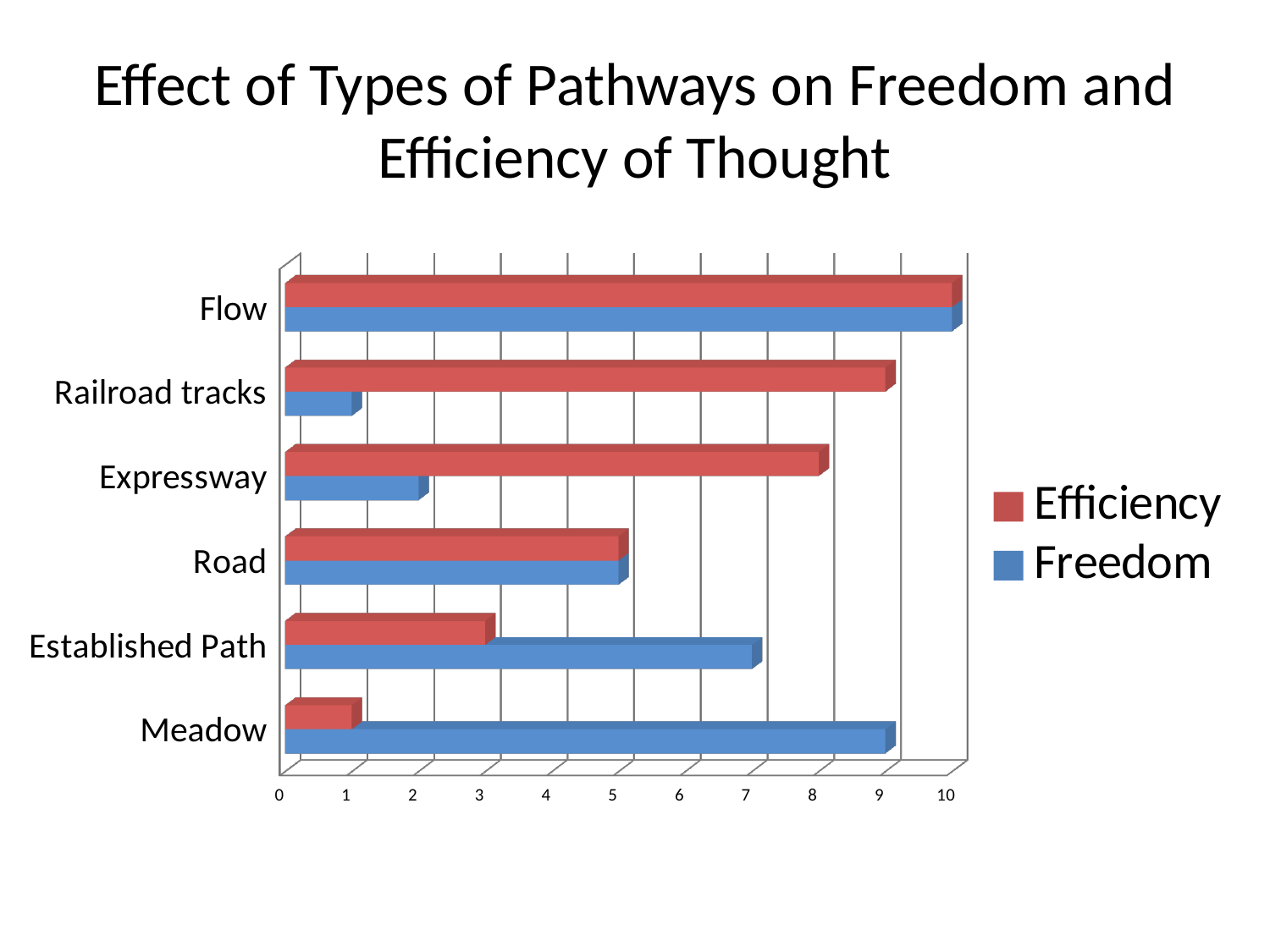
Which colour represents the Freedom series in the legend? Blue Which category has the highest Freedom value? Flow For Established Path, which is larger, the Efficiency value or the Freedom value? Freedom For Meadow, which is larger, the Efficiency value or the Freedom value? Freedom Which category has the lowest Efficiency value? Meadow How many pathway categories are plotted on the chart? 6 How many series does the legend list? 2 Is the Freedom value for Expressway greater or less than 5? less What is the title of the chart on the slide? Effect of Types of Pathways on Freedom and Efficiency of Thought Which category has the lowest Freedom value? Railroad tracks What kind of chart is shown on the slide? Bar chart Is the Efficiency value for Railroad tracks greater or less than 5? greater